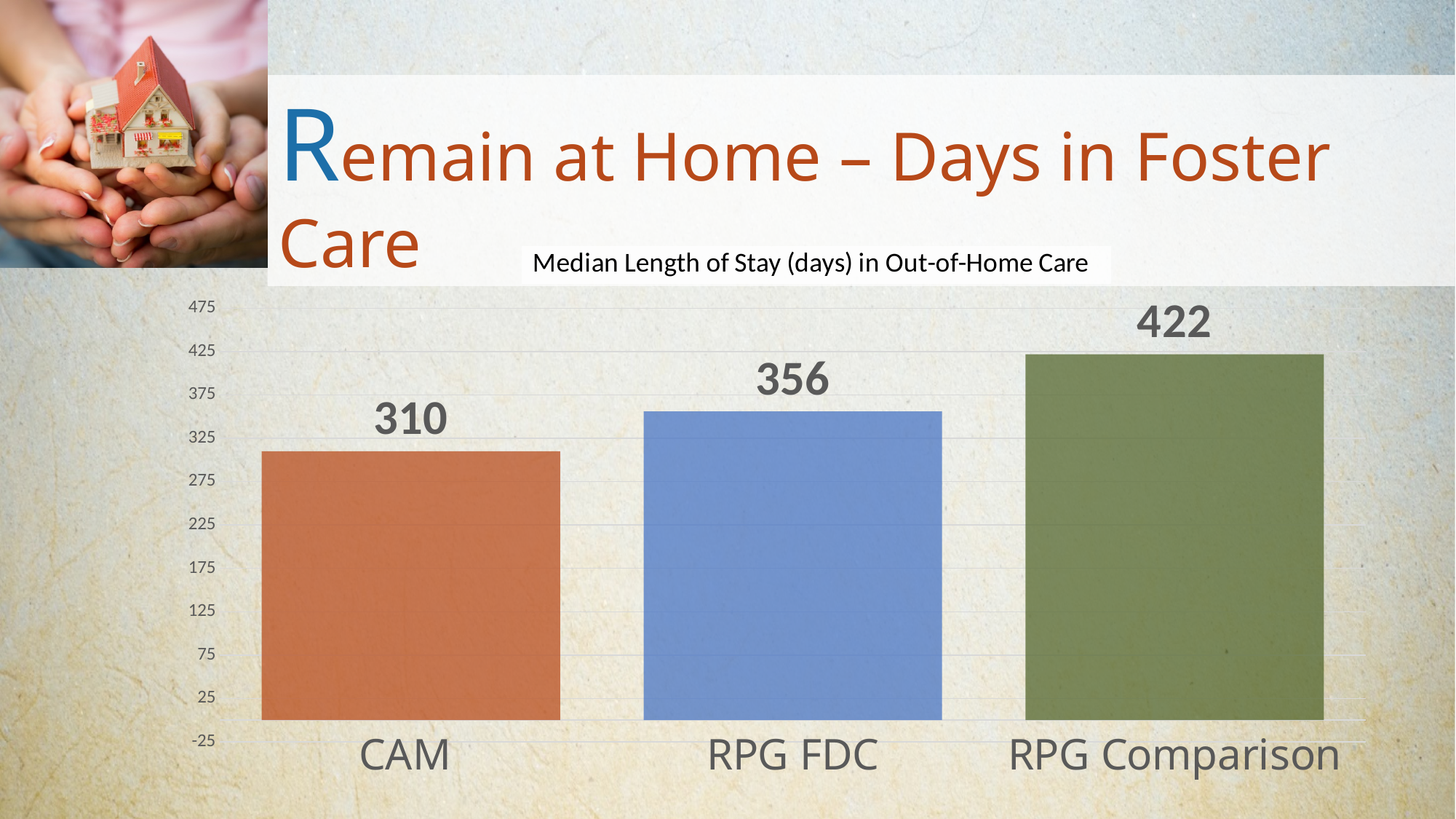
How many categories are shown in the chart? 3 What is the median length of stay for CAM? 310 Is the value for RPG Comparison greater or less than 375? greater Which category has the lowest median length of stay? CAM What is the median length of stay for RPG Comparison? 422 Which is larger, the value for RPG FDC or the value for CAM? RPG FDC What kind of chart is shown on the slide? bar chart What is the difference between the RPG Comparison and CAM values? 112 What is the difference between the RPG FDC and CAM values? 46 Which category has the highest median length of stay? RPG Comparison What is the title of the chart? Median Length of Stay (days) in Out-of-Home Care What is the median length of stay for RPG FDC? 356